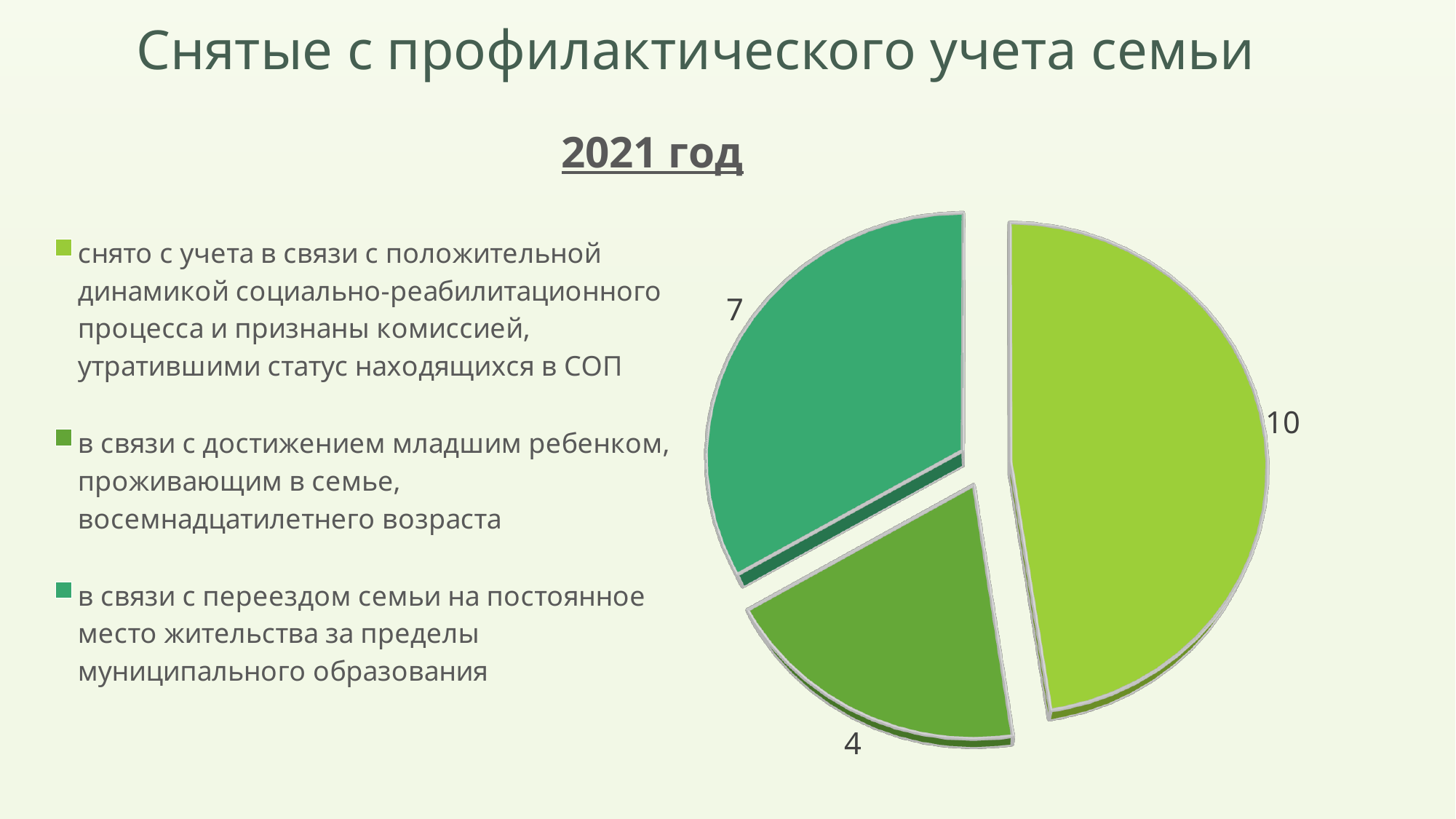
Which category has the smallest slice in the pie chart? в связи с достижением младшим ребенком восемнадцатилетнего возраста What is the value of the slice for "в связи с достижением младшим ребенком, проживающим в семье, восемнадцатилетнего возраста"? 4 Which category has the largest slice in the pie chart? снято с учета в связи с положительной динамикой социально-реабилитационного процесса What is the value of the slice for "в связи с переездом семьи на постоянное место жительства за пределы муниципального образования"? 7 What is the difference between the largest slice (10) and the smallest slice (4)? 6 What kind of chart is shown on the slide? pie chart Which is larger: the slice for families that moved away (переезд) or the slice for the youngest child reaching 18? the slice for families that moved away (7) Which year does the pie chart refer to, according to the subtitle? 2021 год How many categories does the legend list? 3 What is the value of the slice for families removed from the register due to positive dynamics ("снято с учета в связи с положительной динамикой...")? 10 What is the total of all three slices in the pie chart? 21 How many slices does the pie chart have? 3